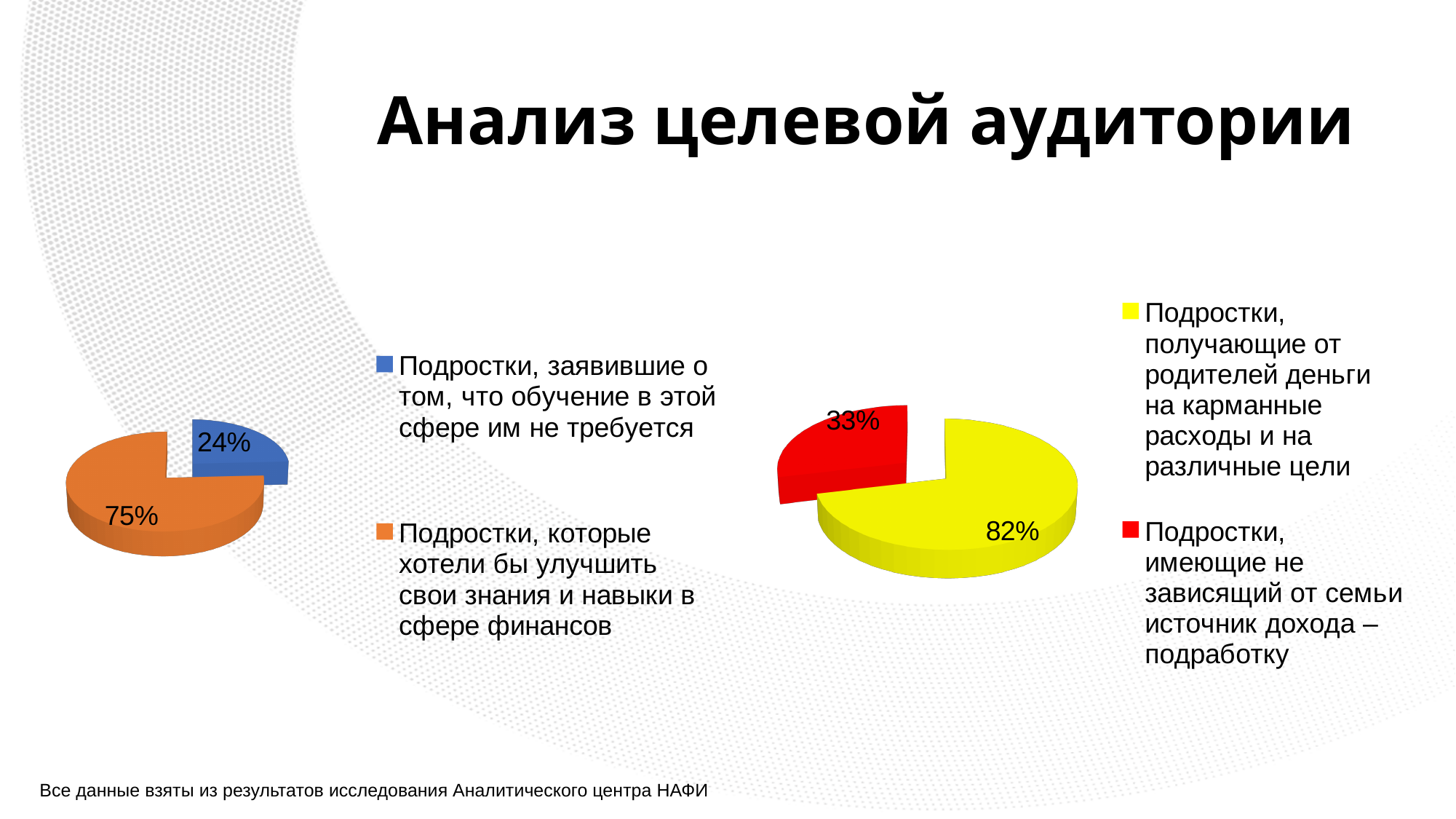
On the right pie chart, what percentage is shown for teenagers with an income source independent of their family (Подростки, имеющие не зависящий от семьи источник дохода – подработку)? 33% On the right pie chart, what colour is the slice for teenagers with an income source independent of their family? Red On the left pie chart, what is the difference in percentage points between the 75% slice and the 24% slice? 51 On the right pie chart, what percentage is shown for teenagers receiving pocket money from their parents (Подростки, получающие от родителей деньги на карманные расходы и на различные цели)? 82% On the left pie chart, what percentage is shown for teenagers who would like to improve their financial knowledge and skills (Подростки, которые хотели бы улучшить свои знания и навыки в сфере финансов)? 75% On the right pie chart, which is larger: the slice for teenagers receiving pocket money from parents or the slice for teenagers with a part-time job income? Teenagers receiving pocket money from parents (82%) How many slices does the left pie chart have? 2 What type of chart is the right chart on the slide? Pie chart On the left pie chart, which category has the largest slice? Подростки, которые хотели бы улучшить свои знания и навыки в сфере финансов On the right pie chart, what is the difference in percentage points between the 82% slice and the 33% slice? 49 On the left pie chart, what percentage is shown for teenagers who said they do not need training in this area (Подростки, заявившие о том, что обучение в этой сфере им не требуется)? 24% On the right pie chart, which category has the smallest slice? Подростки, имеющие не зависящий от семьи источник дохода – подработку